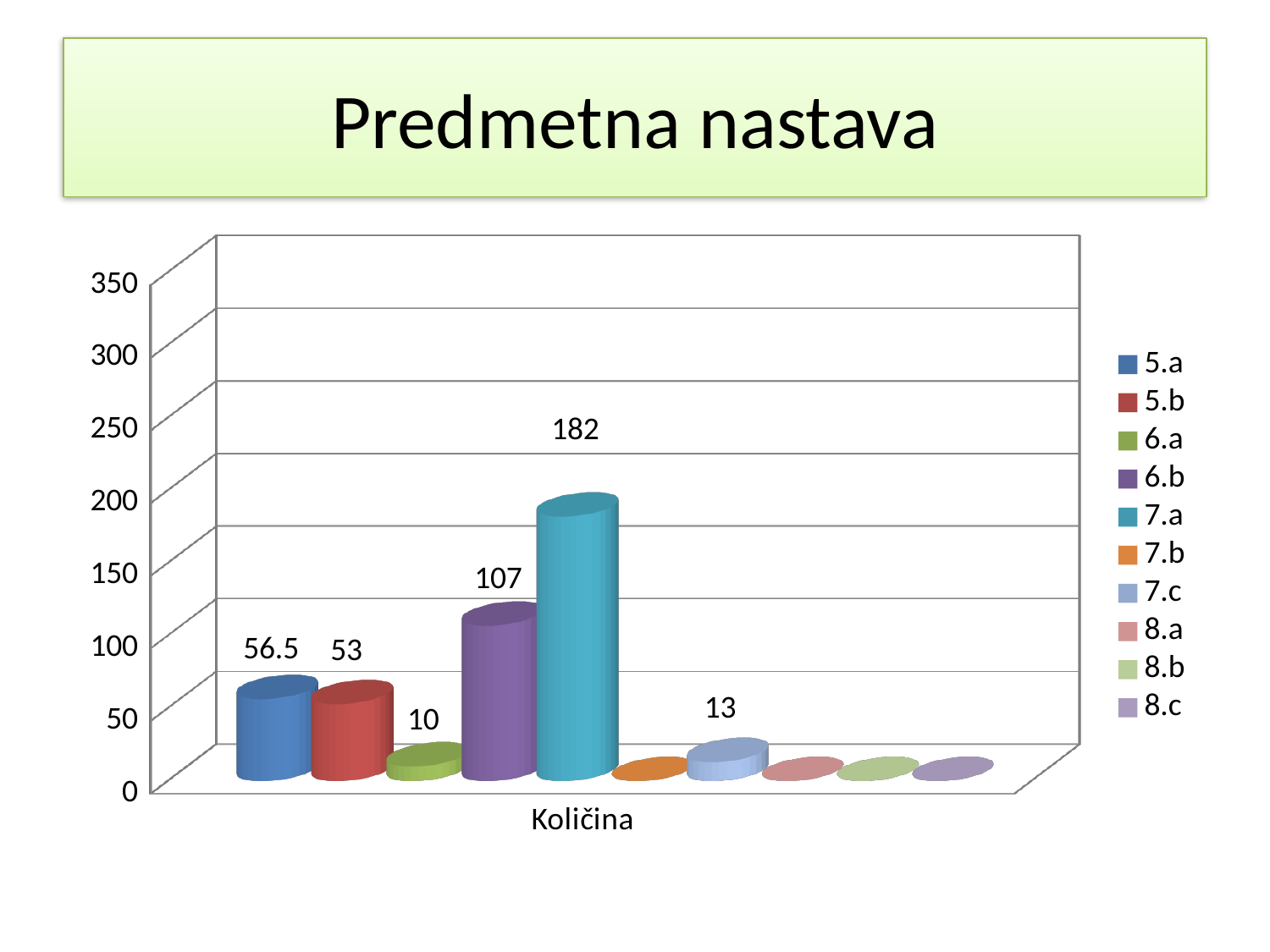
Which series has the highest value? 7.a Is the value for 7.a greater or less than 150? greater What is the label on the x axis of the chart? Količina What is the value for 7.a? 182 What is the value for 5.a? 56.5 What is the value for 6.a? 10 What is the value for 7.c? 13 What is the value for 6.b? 107 What is the difference between the values for 7.a and 6.b? 75 How many series does the legend list? 10 Which is larger, the value for 5.a or the value for 5.b? 5.a What kind of chart is shown on the slide? Bar chart